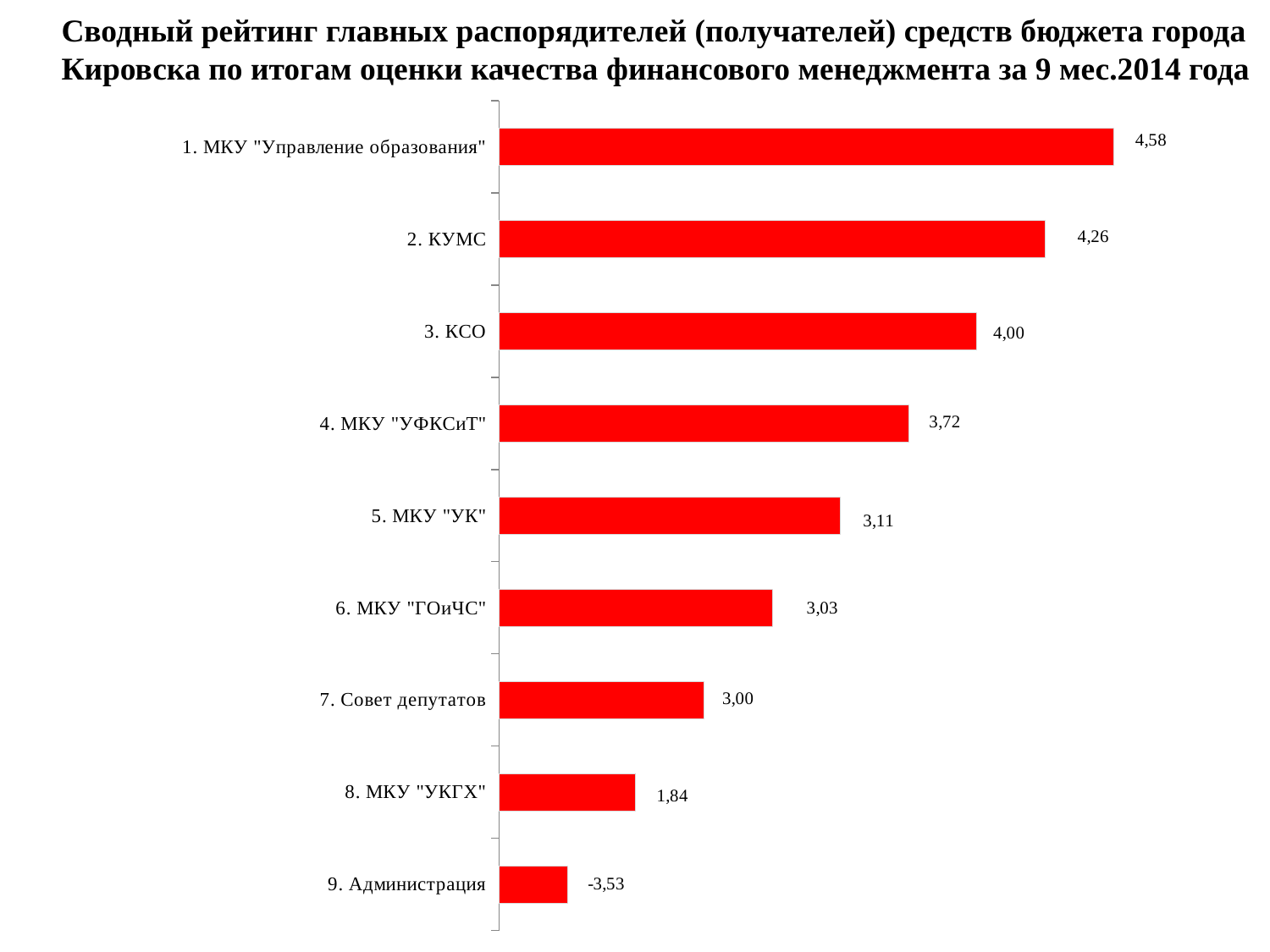
What kind of chart is shown on the slide? Bar chart What is the value for 1. МКУ "Управление образования"? 4,58 Which is larger, the value for 6. МКУ "ГОиЧС" or the value for 8. МКУ "УКГХ"? 6. МКУ "ГОиЧС" What value is labelled for 9. Администрация? -3,53 What colour are the bars in the chart? Red How many categories are shown in the chart? 9 What is the difference between the values for 2. КУМС and 3. КСО? 0,26 What is the value for 5. МКУ "УК"? 3,11 Which category has the lowest labelled value? 9. Администрация What is the value for 8. МКУ "УКГХ"? 1,84 What is the difference between the values for 4. МКУ "УФКСиТ" and 7. Совет депутатов? 0,72 Which category has the highest value? 1. МКУ "Управление образования"